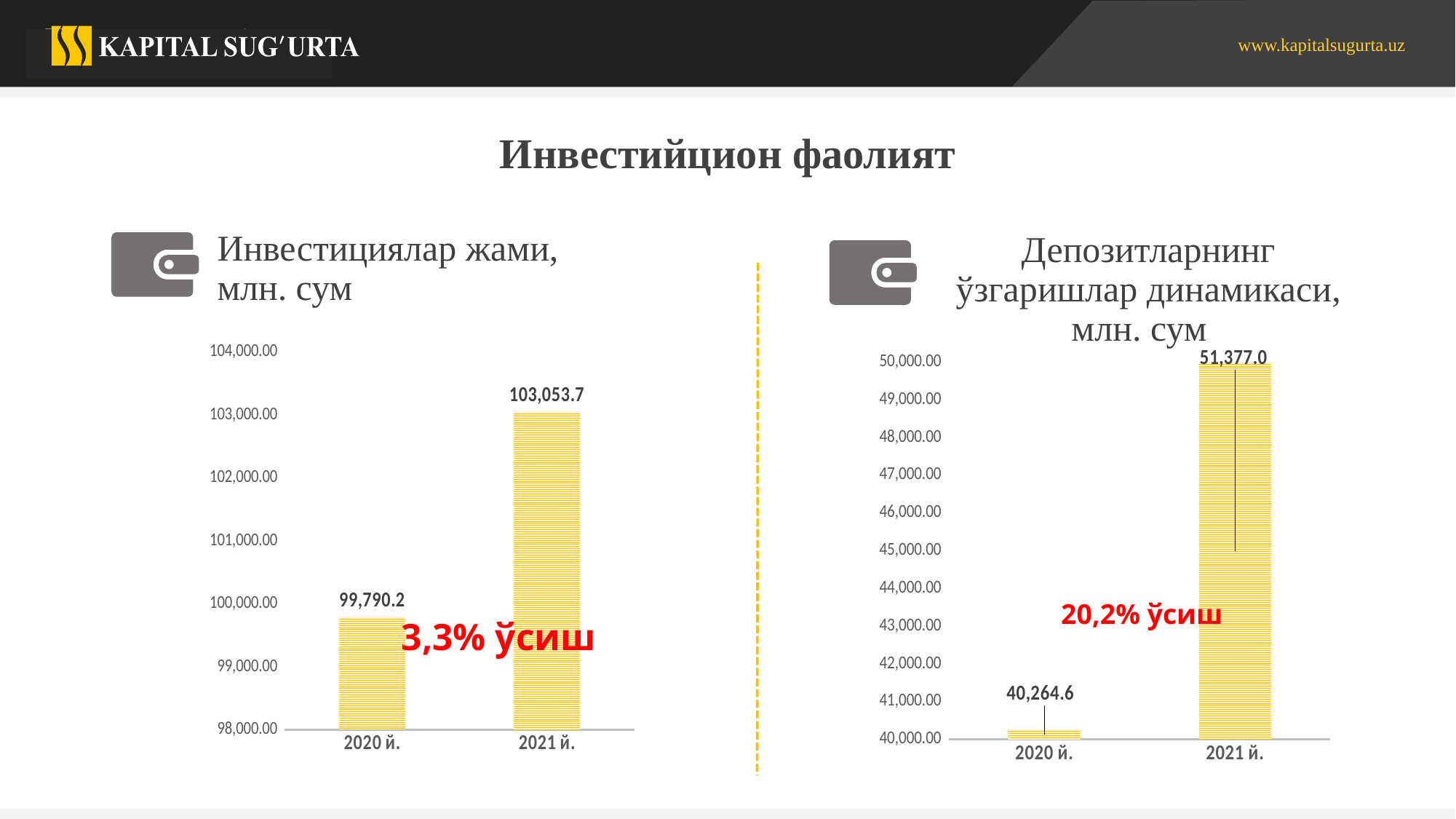
In the right chart (Депозитларнинг ўзгаришлар динамикаси, млн. сум), what is the value for 2020 й.? 40,264.6 In the right chart (Депозитларнинг ўзгаришлар динамикаси, млн. сум), is the value for 2021 й. greater or less than 50,000.00? greater In the left chart (Инвестициялар жами, млн. сум), which year has the higher value? 2021 й. How many categories are shown on the x axis of the right chart (Депозитларнинг ўзгаришлар динамикаси, млн. сум)? 2 What growth percentage is annotated on the right chart (Депозитларнинг ўзгаришлар динамикаси, млн. сум)? 20,2% ўсиш In the right chart (Депозитларнинг ўзгаришлар динамикаси, млн. сум), which year has the lower value? 2020 й. What kind of chart is the left chart (Инвестициялар жами, млн. сум)? bar chart In the right chart (Депозитларнинг ўзгаришлар динамикаси, млн. сум), what is the difference between the 2021 й. and 2020 й. values? 11,112.4 In the right chart (Депозитларнинг ўзгаришлар динамикаси, млн. сум), what is the value for 2021 й.? 51,377.0 In the left chart (Инвестициялар жами, млн. сум), what is the value for 2021 й.? 103,053.7 In the left chart (Инвестициялар жами, млн. сум), what is the difference between the 2021 й. and 2020 й. values? 3,263.5 In the left chart (Инвестициялар жами, млн. сум), what is the value for 2020 й.? 99,790.2